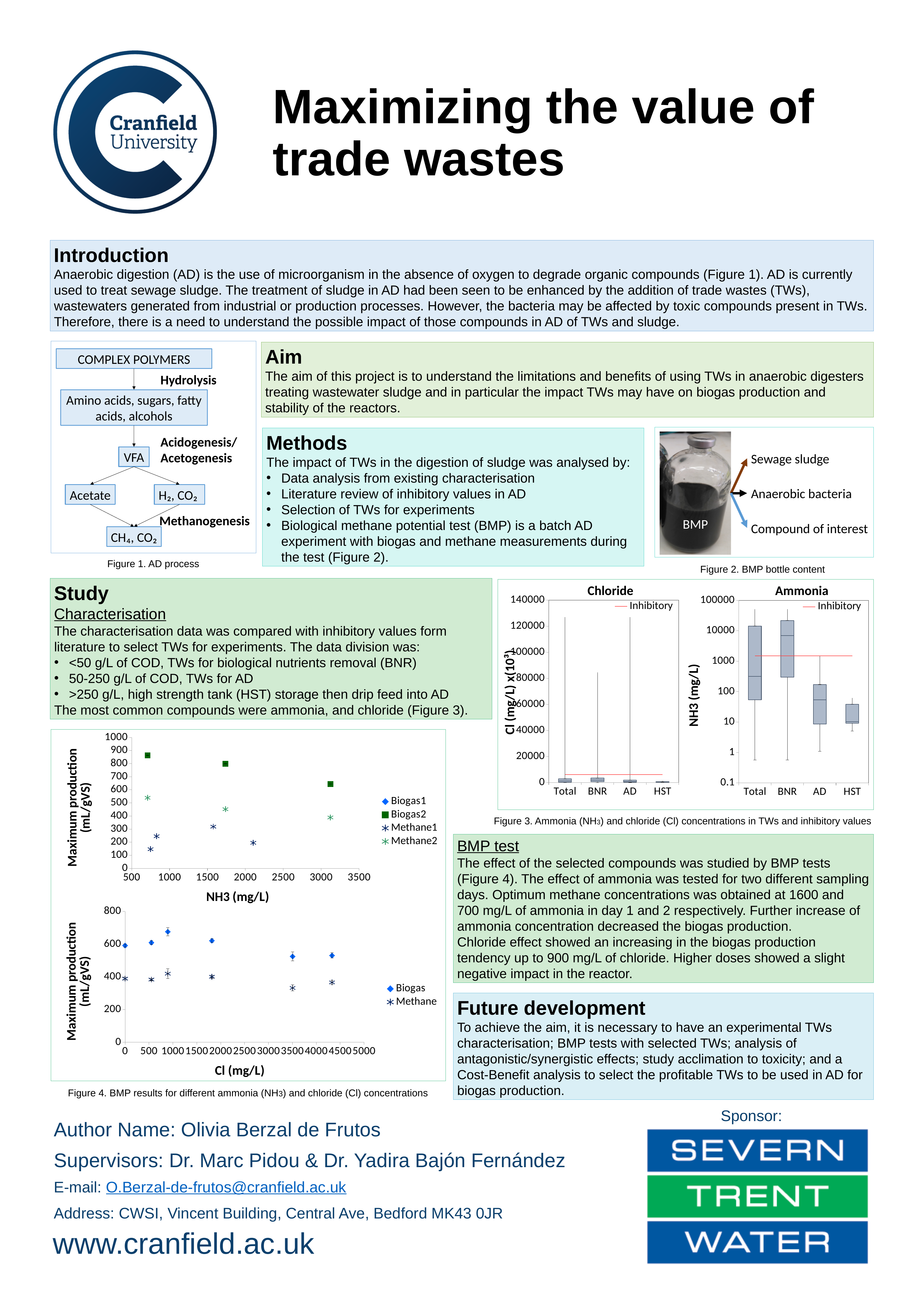
In the Ammonia chart, what entry does the legend list? Inhibitory In the Figure 4 chart with NH3 on the x axis, do the Biogas2 values rise or fall as NH3 increases? fall In the Figure 4 chart with NH3 on the x axis, is the Methane2 value at about 700 mg/L NH3 greater or less than 500? greater In the Figure 4 chart with NH3 on the x axis, how many series does the legend list? 4 In the Ammonia chart, which category has the lowest box? HST In the Ammonia chart, is the box for HST greater or less than 100 mg/L? less In the Ammonia chart, which category has the highest median? BNR In the Figure 4 chart with Cl on the x axis, how many series does the legend list? 2 In the Chloride chart, is the top whisker for BNR greater or less than 100000? less In the Figure 4 chart with Cl on the x axis, which series has the higher values, Biogas or Methane? Biogas In the Chloride chart, how many categories are shown on the x axis? 4